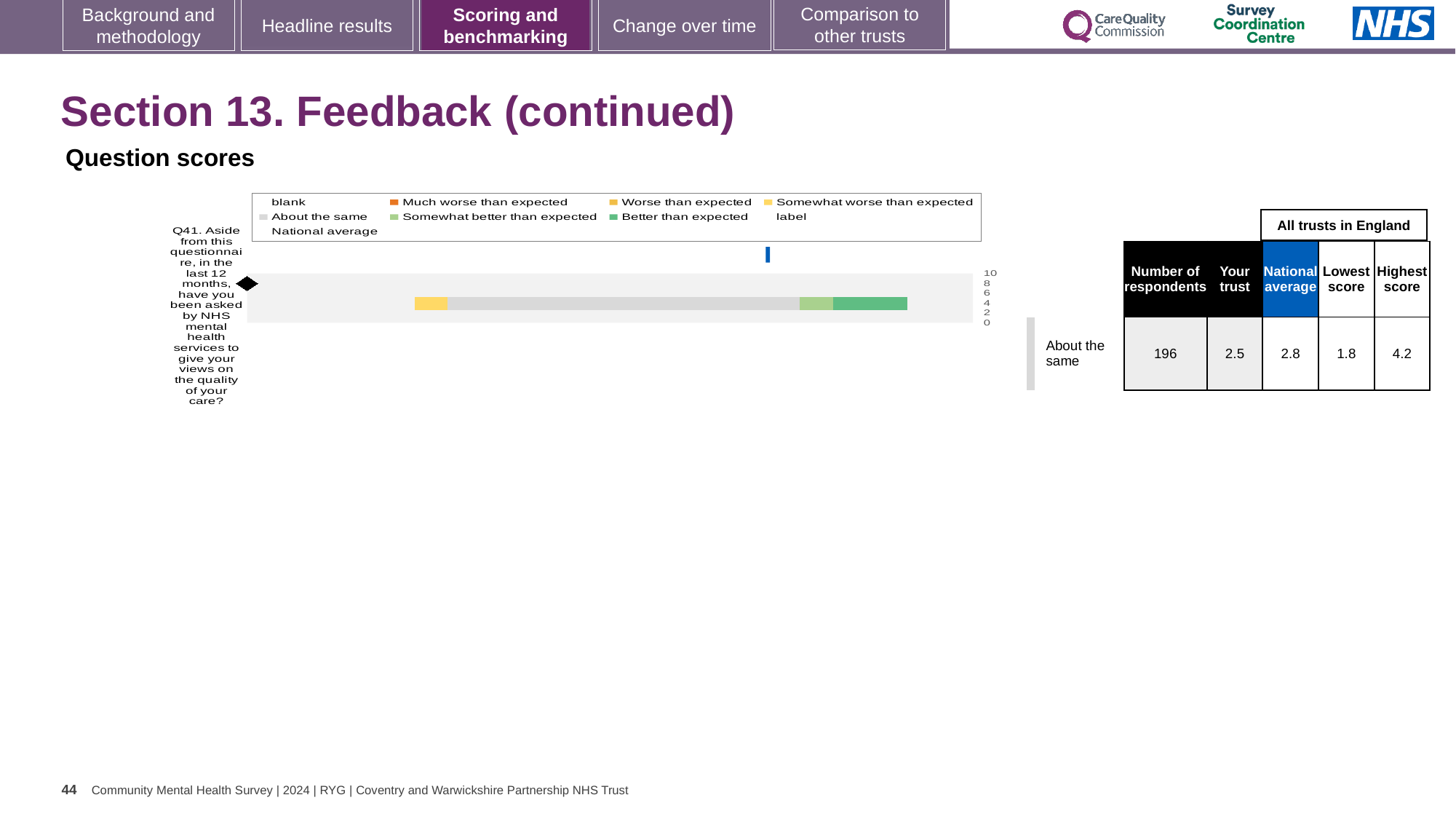
What kind of chart is shown on the slide? bar chart What is the difference between the highest and lowest scores for Q41? 2.4 What is the highest score among all trusts in England for Q41? 4.2 What is the national average score for Q41? 2.8 What is the score for 'Your trust' for Q41? 2.5 How many questions (categories) are plotted in the chart? 1 How many respondents answered Q41? 196 What benchmark category is the trust's Q41 score placed in? About the same Which question is plotted in the chart? Q41. Aside from this questionnaire, in the last 12 months, have you been asked by NHS mental health services to give your views on the quality of your care? What is the lowest score among all trusts in England for Q41? 1.8 Is the trust's score for Q41 greater or less than 4 on the chart axis? less Which is larger for Q41, the trust's score or the national average? National average